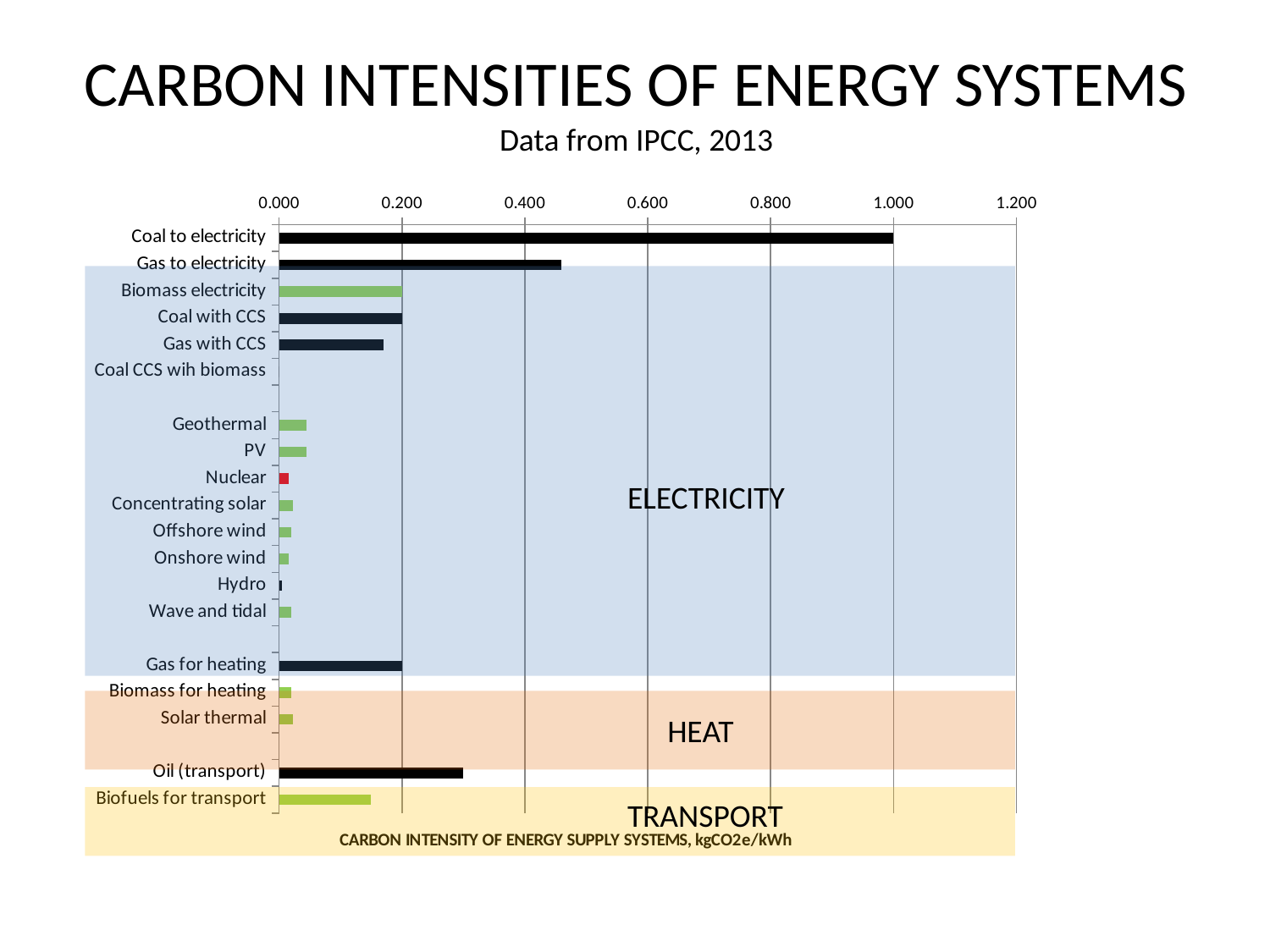
What is the carbon intensity value for Coal to electricity? 1.000 What type of chart is shown on the slide? Bar chart What is the carbon intensity value for Gas for heating? 0.200 Is the value for Biofuels for transport greater or less than 0.200? less Is the value for Oil (transport) greater or less than 0.400? less How many labelled categories are shown on the chart? 19 Which category has the highest carbon intensity? Coal to electricity What is the carbon intensity value for Coal with CCS? 0.200 Which has a higher carbon intensity, Coal to electricity or Gas to electricity? Coal to electricity What unit is given in the axis title of the chart? kgCO2e/kWh Is the value for Gas to electricity greater or less than 0.400? greater Which has a higher carbon intensity, Oil (transport) or Biofuels for transport? Oil (transport)